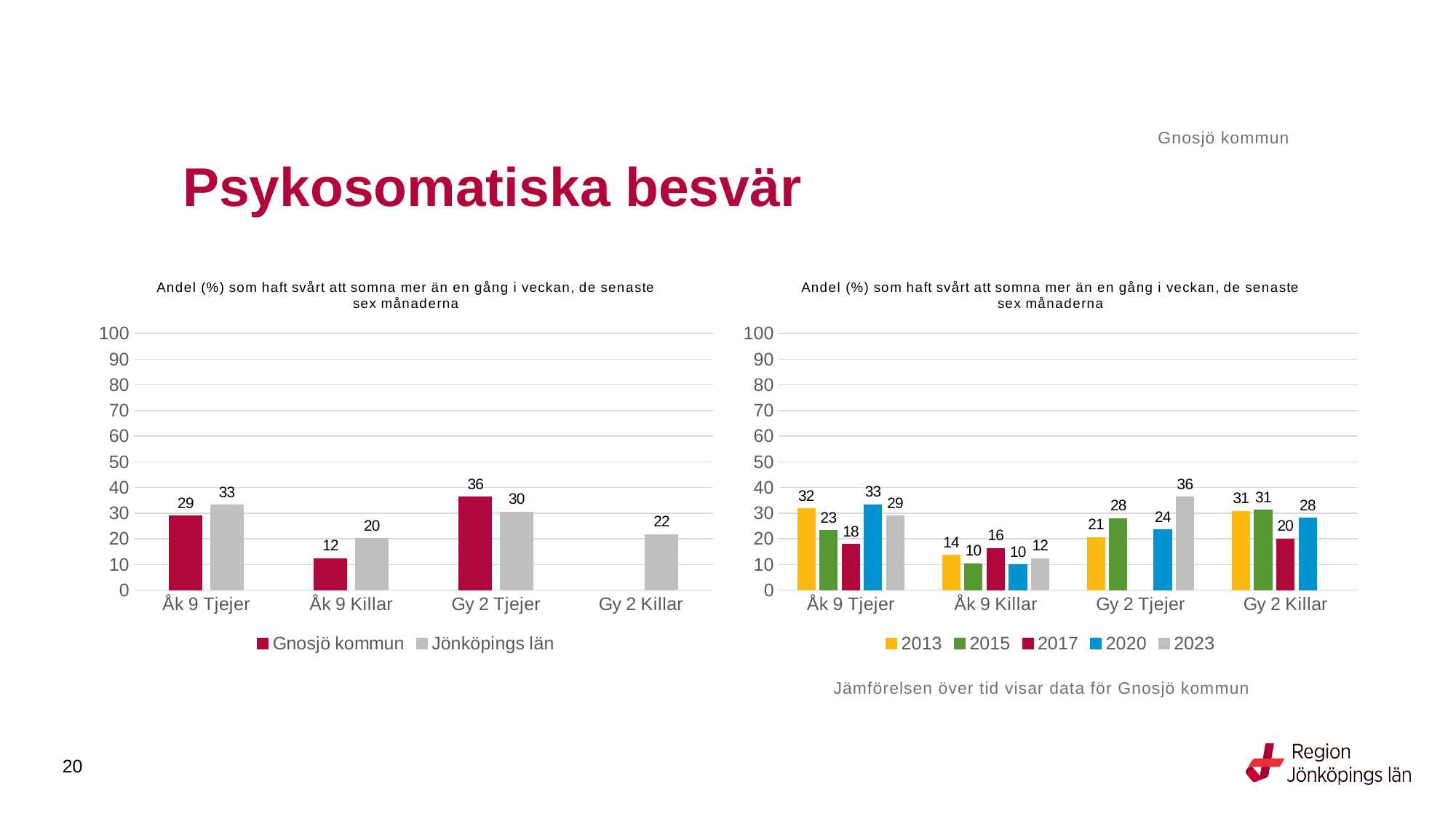
In the left chart, what is the value for Gnosjö kommun for Åk 9 Tjejer? 29 In the right chart, which year has the lowest value for Åk 9 Killar? 2015 and 2020 What type of chart is the right chart? Bar chart In the left chart, which category has the highest value for Gnosjö kommun? Gy 2 Tjejer In the left chart, which is larger for Gy 2 Tjejer: Gnosjö kommun or Jönköpings län? Gnosjö kommun In the right chart, what is the difference between the 2013 and 2017 values for Gy 2 Killar? 11 In the right chart, what is the value for 2020 for Åk 9 Tjejer? 33 In the right chart, what is the value for 2023 for Gy 2 Tjejer? 36 How many series does the legend of the right chart list? 5 In the left chart, what is the difference between Jönköpings län and Gnosjö kommun for Åk 9 Killar? 8 How many series does the legend of the left chart list? 2 In the left chart, what is the value for Jönköpings län for Gy 2 Killar? 22